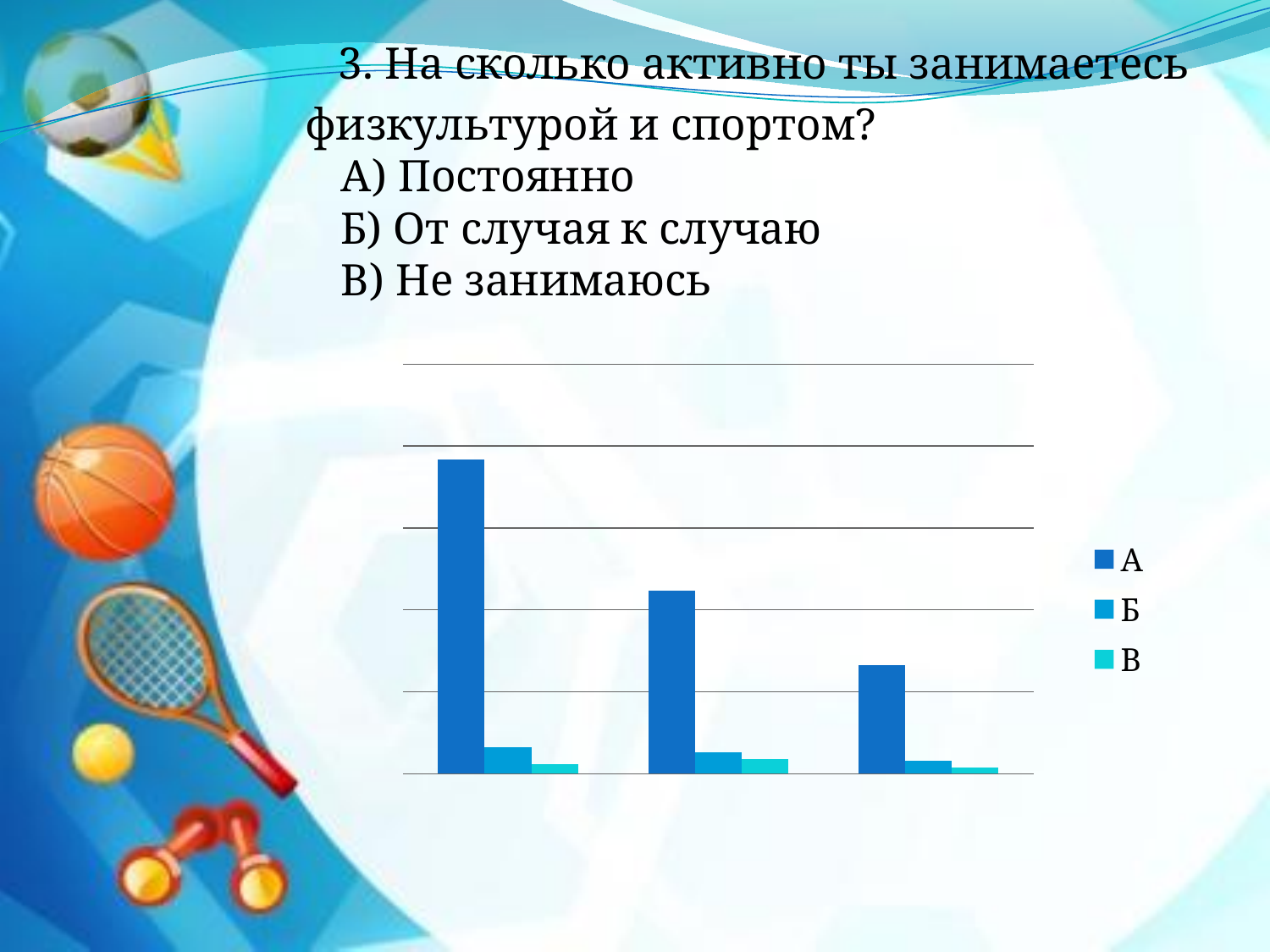
In the first (leftmost) group of bars, which series is larger, Б or В? Б How many groups of bars are plotted in the chart? 3 Which series is shown in the lightest (cyan) colour in the legend? В Which group of bars has the tallest bar for series А, the first, second or third? first Which series has the tallest bar in the chart? А Do the bars for series А rise or fall from left to right across the groups? fall What kind of chart is shown on the slide? bar chart Which series has the shortest bars in the chart? В In the first (leftmost) group of bars, which series is larger, А or Б? А How many series does the chart's legend list? 3 In the third (rightmost) group of bars, which series is larger, А or В? А What are the legend entries of the chart? А, Б, В